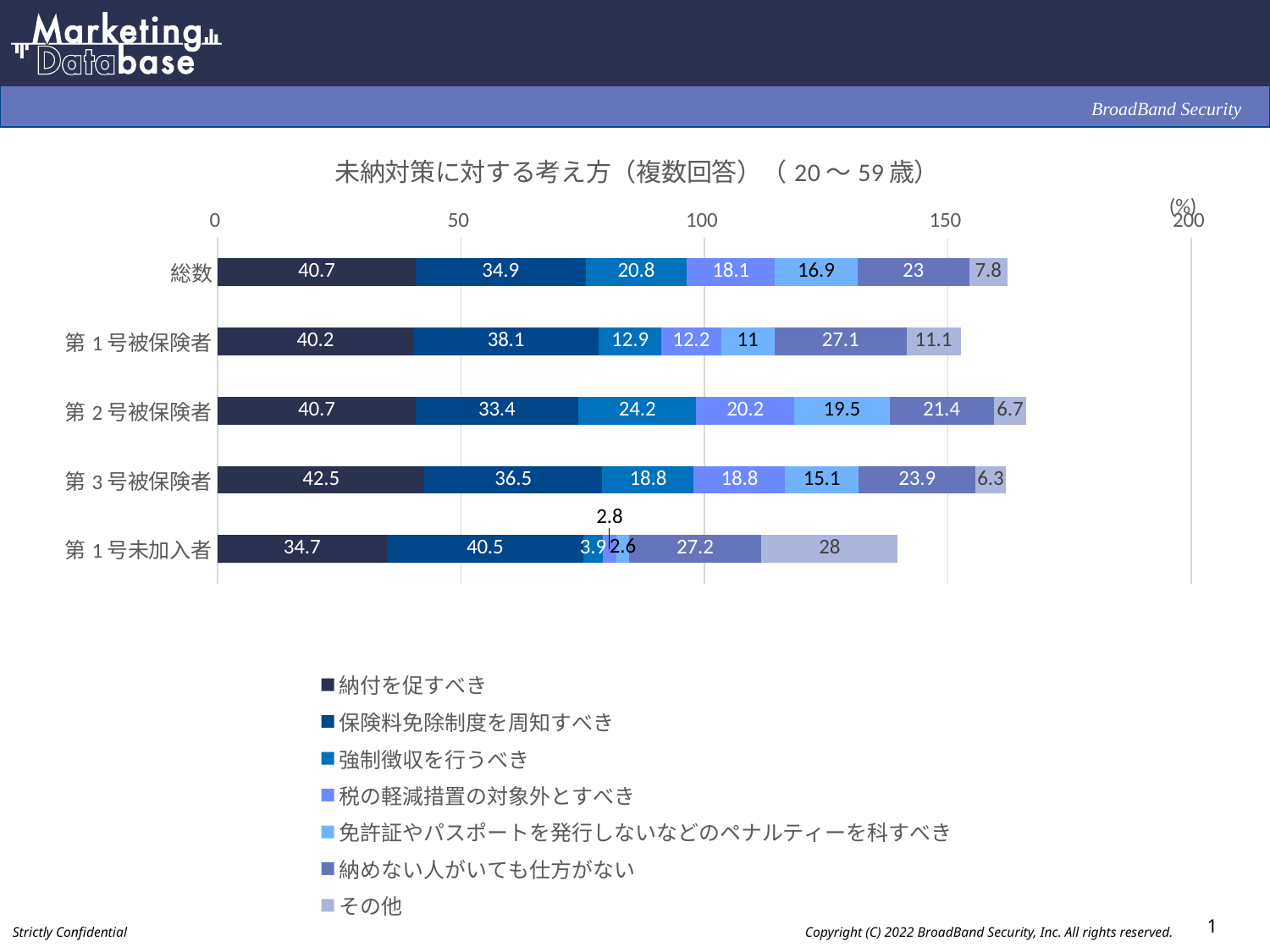
What type of chart is shown on the slide? Stacked horizontal bar chart Which is larger: the 免許証やパスポートを発行しないなどのペナルティーを科すべき value for 第2号被保険者 or for 第3号被保険者? 第2号被保険者 What is the difference between the 納めない人がいても仕方がない values for 第1号被保険者 and 第2号被保険者? 5.7 How many series does the legend list? 7 What is the title of the chart? 未納対策に対する考え方（複数回答）（20～59歳） What is the value of 保険料免除制度を周知すべき for 第1号未加入者? 40.5 What is the value of 納付を促すべき for 第3号被保険者? 42.5 Which category has the lowest value for 強制徴収を行うべき? 第1号未加入者 What is the value of その他 for 第1号被保険者? 11.1 How many categories (rows) are plotted in the chart? 5 What is the total of the stacked bar for 第1号未加入者? 139.7 Which category has the highest value for 納付を促すべき? 第3号被保険者